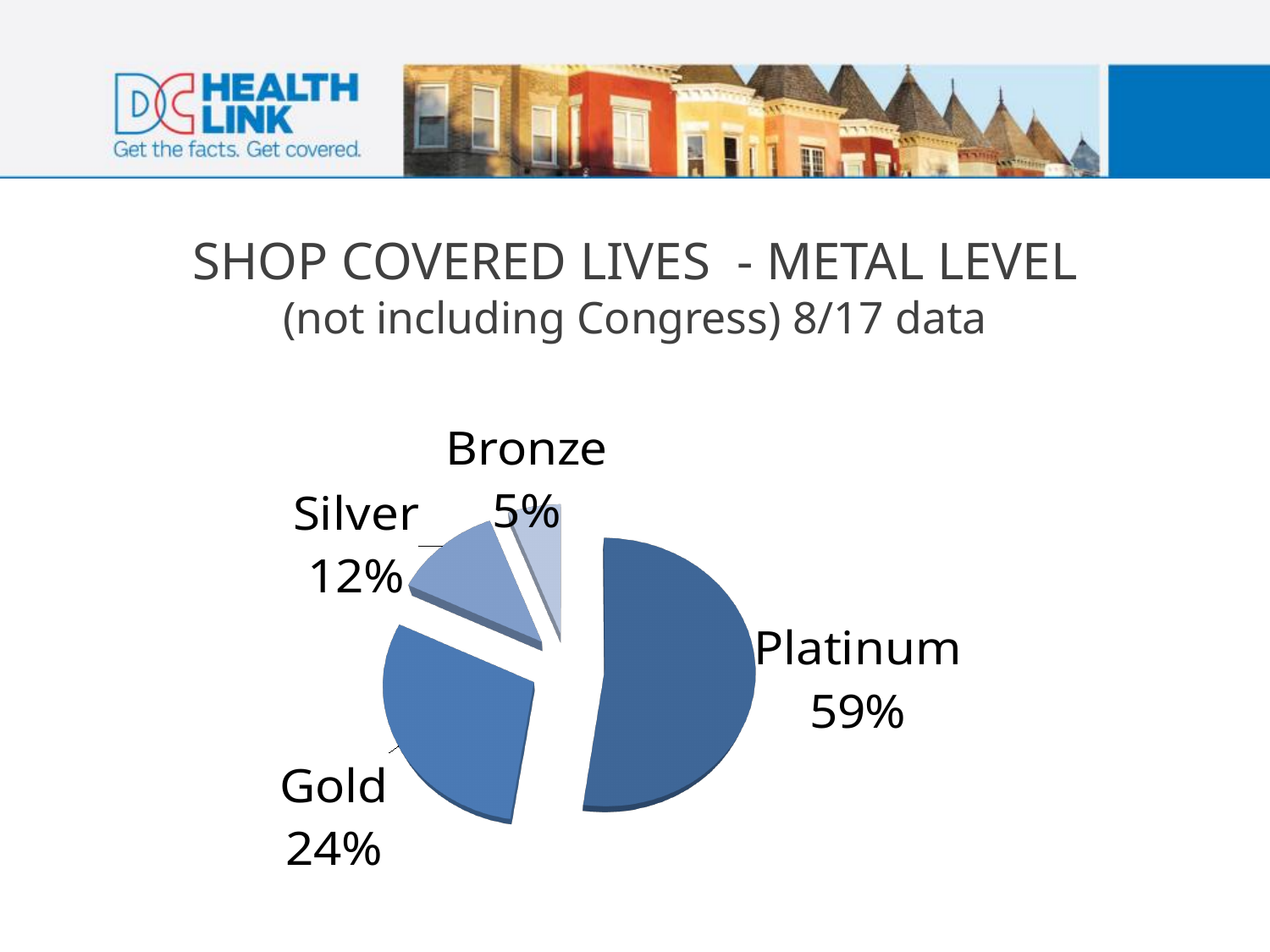
What share of SHOP covered lives is at the Platinum metal level? 59% How many percentage points larger is the Silver share than the Bronze share? 7 What kind of chart is shown on the slide? Pie chart What share of SHOP covered lives is at the Silver metal level? 12% Which metal level has the largest share of SHOP covered lives? Platinum What date is the data in the chart from, according to the title? 8/17 How many percentage points larger is the Platinum share than the Gold share? 35 Which has a larger share of SHOP covered lives, Gold or Silver? Gold What share of SHOP covered lives is at the Gold metal level? 24% Which metal level has the smallest share of SHOP covered lives? Bronze How many metal levels are shown in the pie chart? 4 What share of SHOP covered lives is at the Bronze metal level? 5%